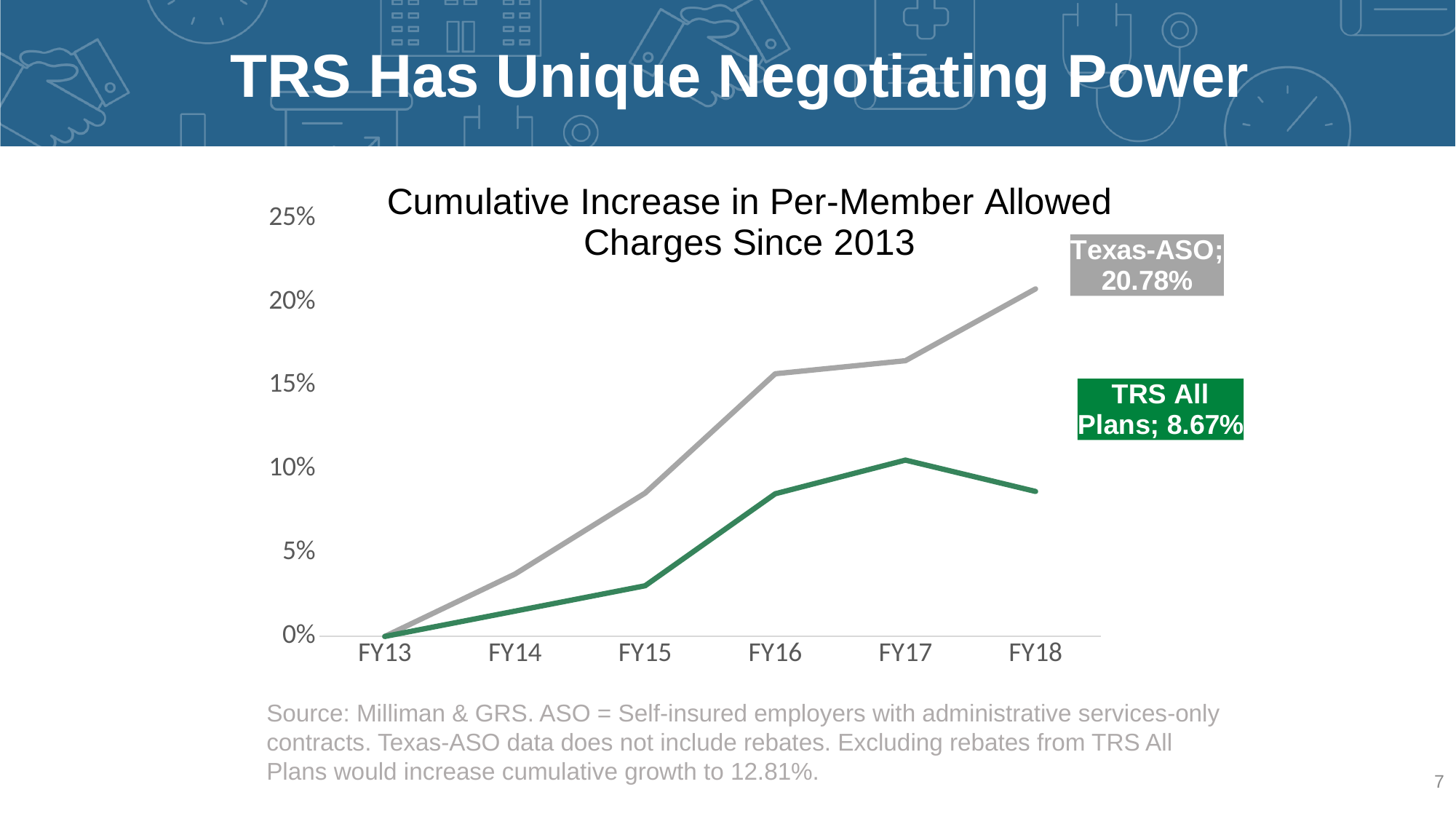
What kind of chart is shown on the slide? line chart Is the value for Texas-ASO in FY15 greater or less than 10%? less How many fiscal years are shown on the x axis? 6 What is the cumulative increase for TRS All Plans in FY18? 8.67% Is the value for Texas-ASO in FY17 greater or less than 15%? greater In which fiscal year does the TRS All Plans line reach its highest point? FY17 How many series are plotted on the chart? 2 What is the difference between the Texas-ASO and TRS All Plans values in FY18? 12.11% Does the Texas-ASO line rise or fall from FY13 to FY18? rise Is the value for TRS All Plans in FY15 greater or less than 5%? less What is the cumulative increase for Texas-ASO in FY18? 20.78% Which series has the higher value in FY18, Texas-ASO or TRS All Plans? Texas-ASO